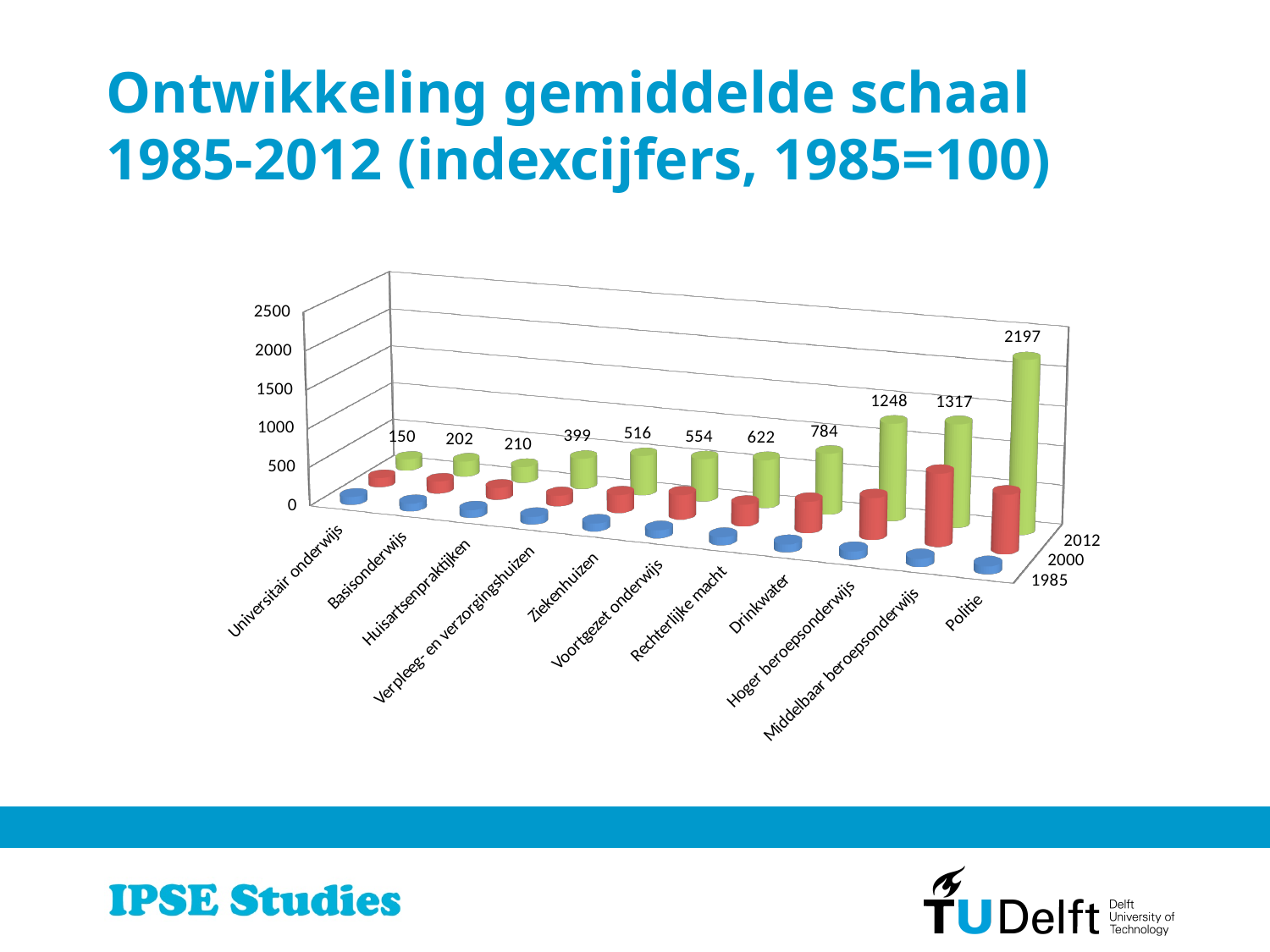
What is the 2012 value for Ziekenhuizen? 516 How many categories are shown on the x axis? 11 Which category has the highest 2012 value? Politie What is the 2012 value for Politie? 2197 Do the 2012 values rise or fall from left to right along the x axis? rise What is the difference between the 2012 values for Middelbaar beroepsonderwijs and Hoger beroepsonderwijs? 69 What is the 2012 value for Universitair onderwijs? 150 Is the 2012 value for Basisonderwijs greater or less than 500? less What is the 2012 value for Drinkwater? 784 Which has a larger 2012 value, Rechterlijke macht or Voortgezet onderwijs? Rechterlijke macht How many series (years) does the chart show? 3 Which category has the lowest 2012 value? Universitair onderwijs